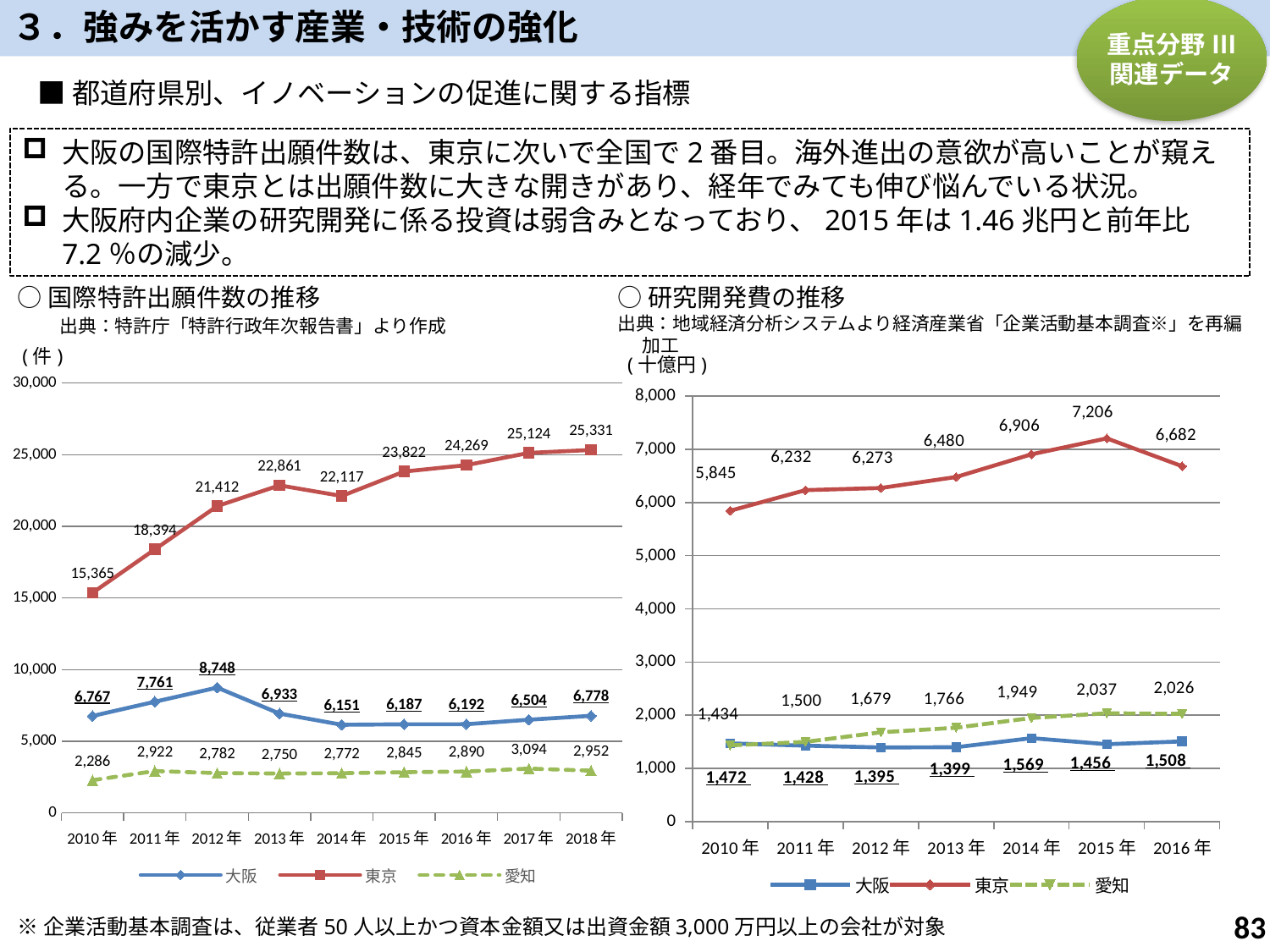
In the 研究開発費の推移 chart, what is the difference between 東京 in 2015年 and 2016年? 524 In the 研究開発費の推移 chart, what is the value for 大阪 in 2013年? 1,399 What type of chart is the 研究開発費の推移 chart? Line chart In the 国際特許出願件数の推移 chart, how many years are shown on the x axis? 9 In the 研究開発費の推移 chart, which is larger in 2016年, 大阪 or 愛知? 愛知 In the 研究開発費の推移 chart, what is the value for 東京 in 2015年? 7,206 In the 国際特許出願件数の推移 chart, what is the value for 大阪 in 2012年? 8,748 In the 研究開発費の推移 chart, in which year is 大阪 at its lowest? 2012年 In the 国際特許出願件数の推移 chart, what is the value for 東京 in 2018年? 25,331 In the 国際特許出願件数の推移 chart, how many series does the legend list? 3 In the 国際特許出願件数の推移 chart, in which year does 大阪 reach its highest value? 2012年 In the 国際特許出願件数の推移 chart, what is the difference between 東京 and 大阪 in 2018年? 18,553